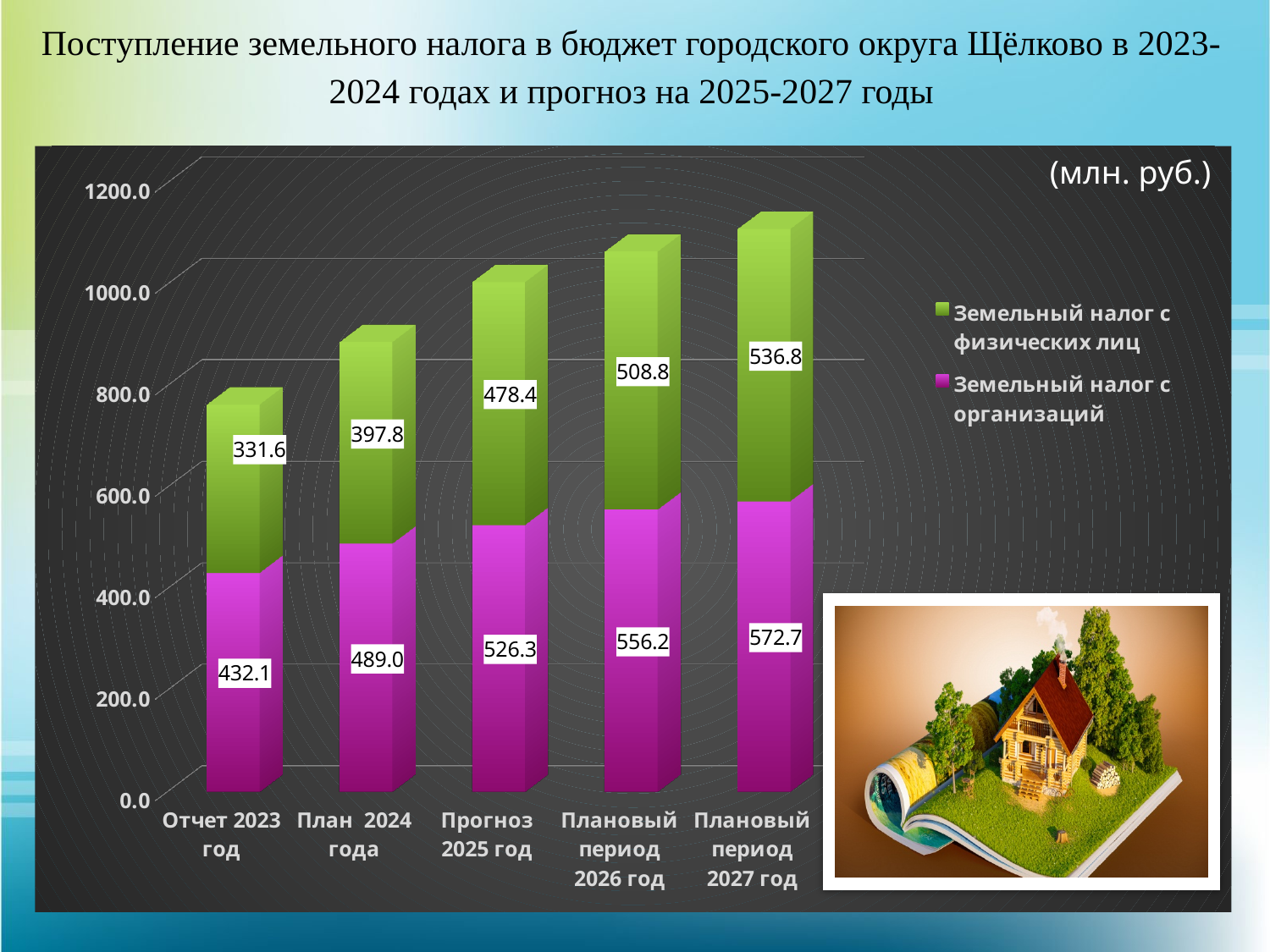
Which is larger for 'Плановый период 2026 год': 'Земельный налог с организаций' or 'Земельный налог с физических лиц'? Земельный налог с организаций What is the difference between 'Земельный налог с организаций' and 'Земельный налог с физических лиц' for 'План 2024 года'? 91.2 How many series does the legend list? 2 How many categories are shown on the x axis? 5 Does the value of 'Земельный налог с физических лиц' rise or fall from 'Отчет 2023 год' to 'Плановый период 2027 год'? rise Which category has the highest value for 'Земельный налог с организаций'? Плановый период 2027 год What is the total of the stacked bar for 'Отчет 2023 год'? 763.7 What is the value of 'Земельный налог с физических лиц' for 'Прогноз 2025 год'? 478.4 What is the total of the stacked bar for 'Плановый период 2027 год'? 1109.5 What is the value of 'Земельный налог с физических лиц' for 'Плановый период 2027 год'? 536.8 What is the value of 'Земельный налог с организаций' for 'Отчет 2023 год'? 432.1 Which category has the lowest value for 'Земельный налог с физических лиц'? Отчет 2023 год